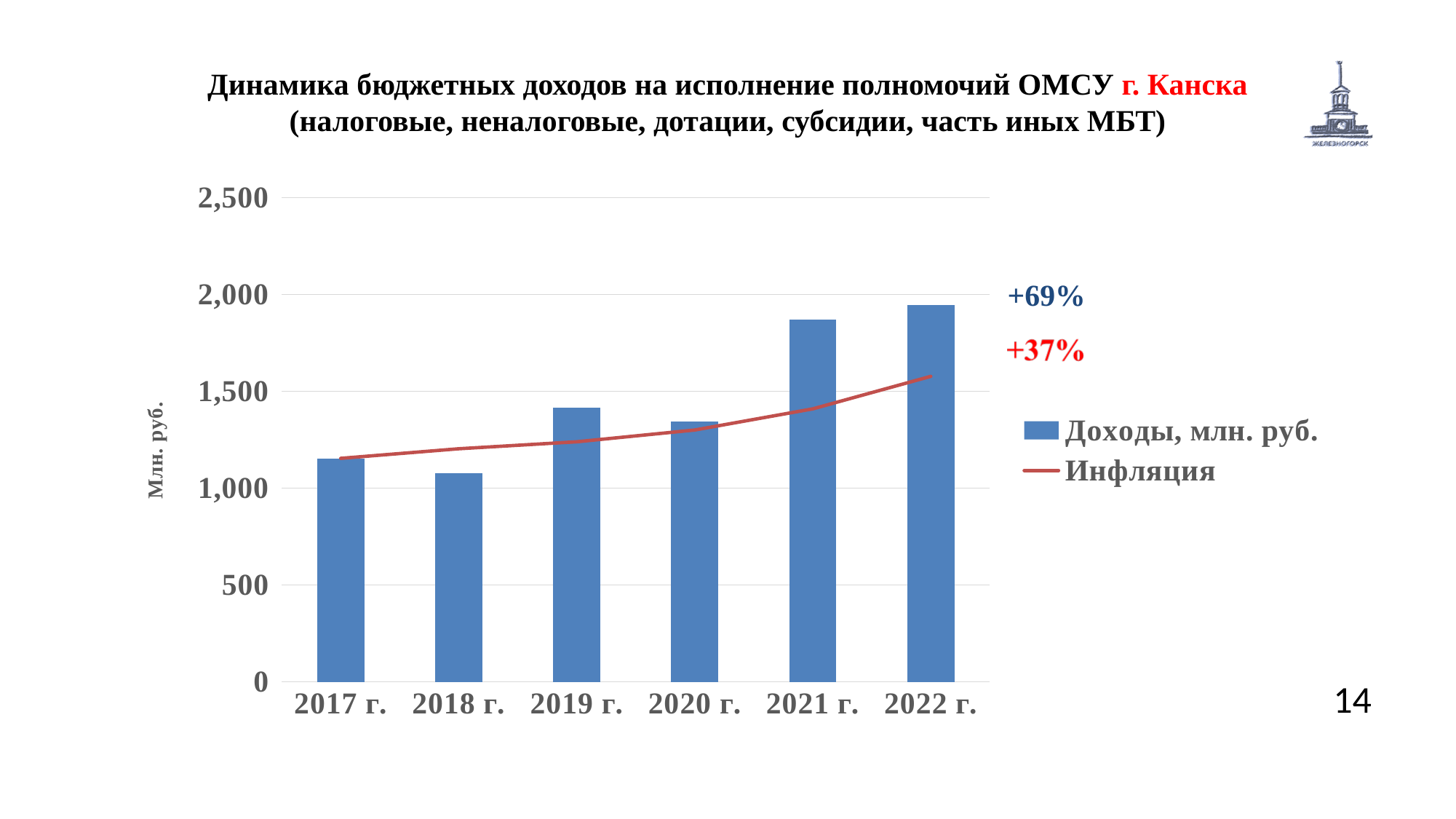
How many series does the chart legend list? 2 How many years are shown on the x axis of the chart? 6 Is the value for Доходы in 2018 г. greater or less than 1,000? greater Is the value for Доходы in 2022 г. greater or less than 2,000? less Which year has the highest bar for Доходы, млн. руб.? 2022 г. What is the unit label on the vertical axis of the chart? Млн. руб. Which year has the larger Доходы bar, 2019 г. or 2020 г.? 2019 г. Is the value for Доходы in 2021 г. greater or less than 1,500? greater What kind of chart is shown on the slide? Bar chart with a line overlay Does the Инфляция line rise or fall from 2017 г. to 2022 г.? Rises Which year has the lowest bar for Доходы, млн. руб.? 2018 г.